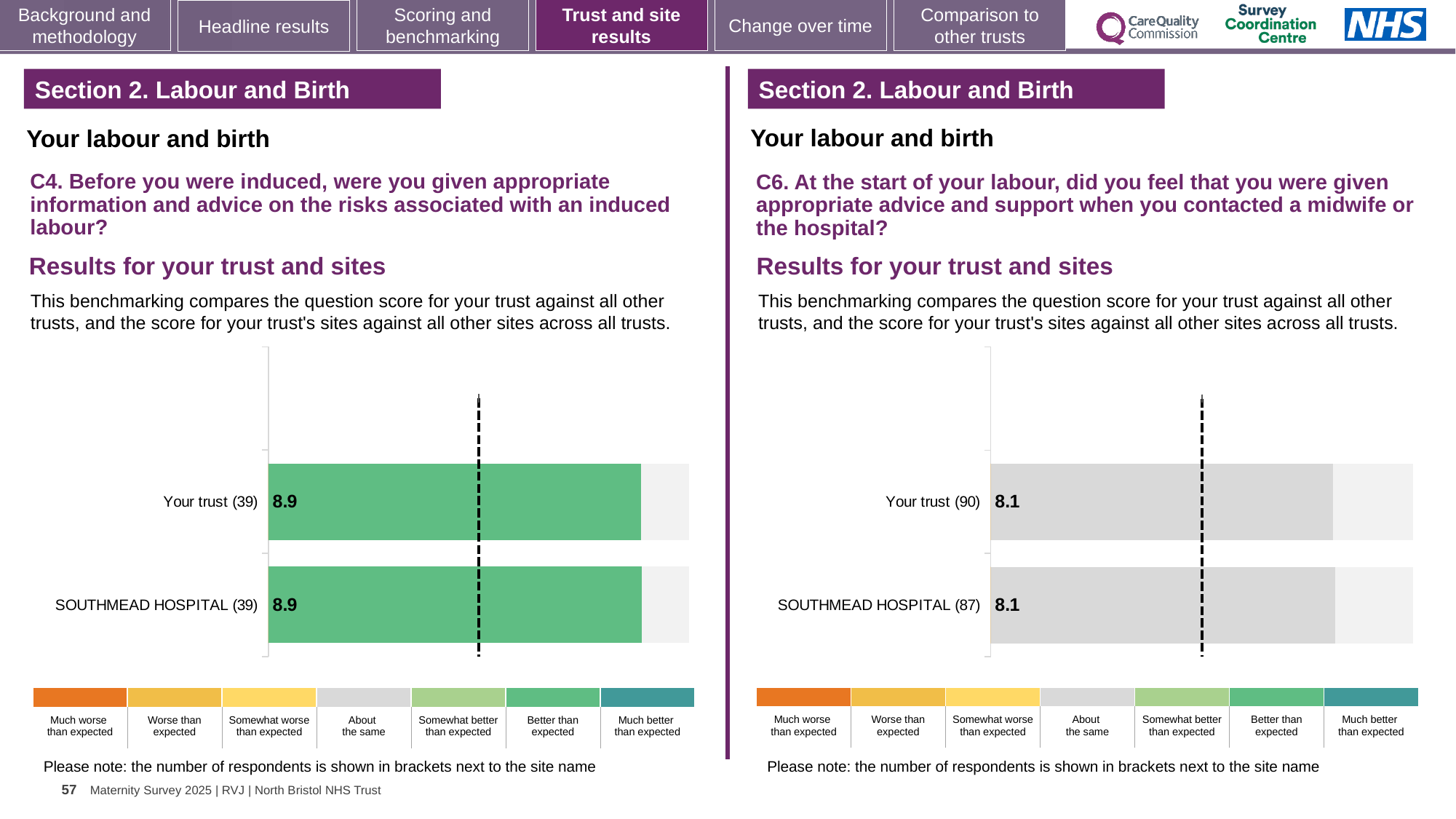
In the C6 chart on the right, what is the score for SOUTHMEAD HOSPITAL? 8.1 In the C4 chart on the left, how many respondents are shown in brackets for SOUTHMEAD HOSPITAL? 39 In the C4 chart on the left, what is the difference between the score for Your trust and the score for SOUTHMEAD HOSPITAL? 0 In the C6 chart on the right, how many respondents are shown in brackets for Your trust? 90 What kind of chart is the C4 chart on the left? Bar chart In the C6 chart on the right, what is the score for Your trust? 8.1 In the C4 chart on the left, what is the score for Your trust? 8.9 In the C4 chart on the left, what is the score for SOUTHMEAD HOSPITAL? 8.9 How many bars are plotted in the C6 chart on the right? 2 How many bars are plotted in the C4 chart on the left? 2 In the C6 chart on the right, what is the difference between the score for Your trust and the score for SOUTHMEAD HOSPITAL? 0 According to the colour key, which benchmark category do the green bars in the C4 chart on the left represent? Better than expected